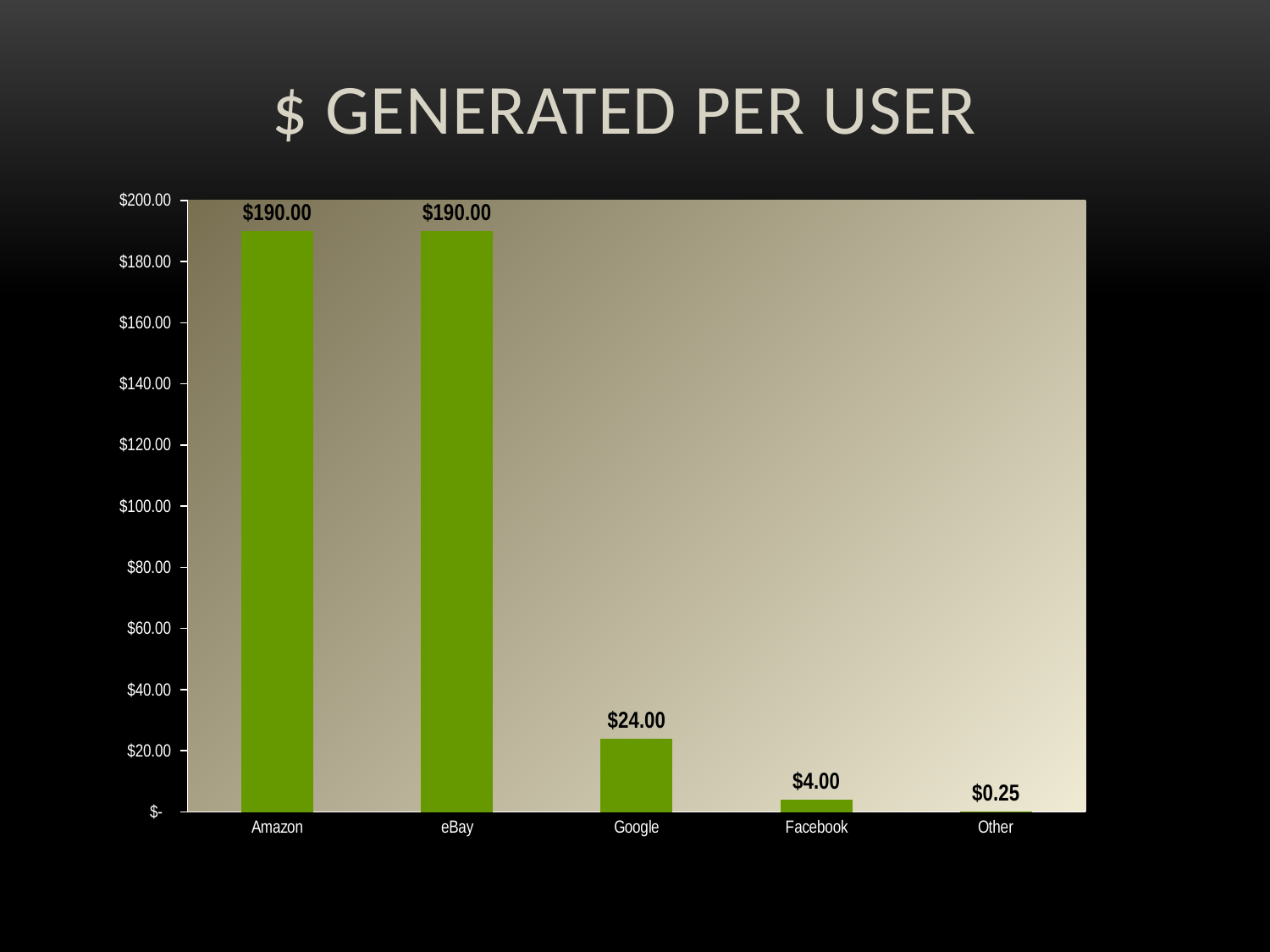
What is the difference between the values for eBay and Google? $166.00 What is the value for Amazon? $190.00 What is the title of the chart? $ GENERATED PER USER What is the value for Other? $0.25 How many categories are shown on the x axis? 5 What kind of chart is shown on the slide? bar chart Is the value for Amazon greater or less than $180.00? greater Which is larger, the value for Google or the value for Facebook? Google What is the value for Google? $24.00 Which category has the lowest value? Other What is the difference between the values for Google and Facebook? $20.00 What is the value for Facebook? $4.00